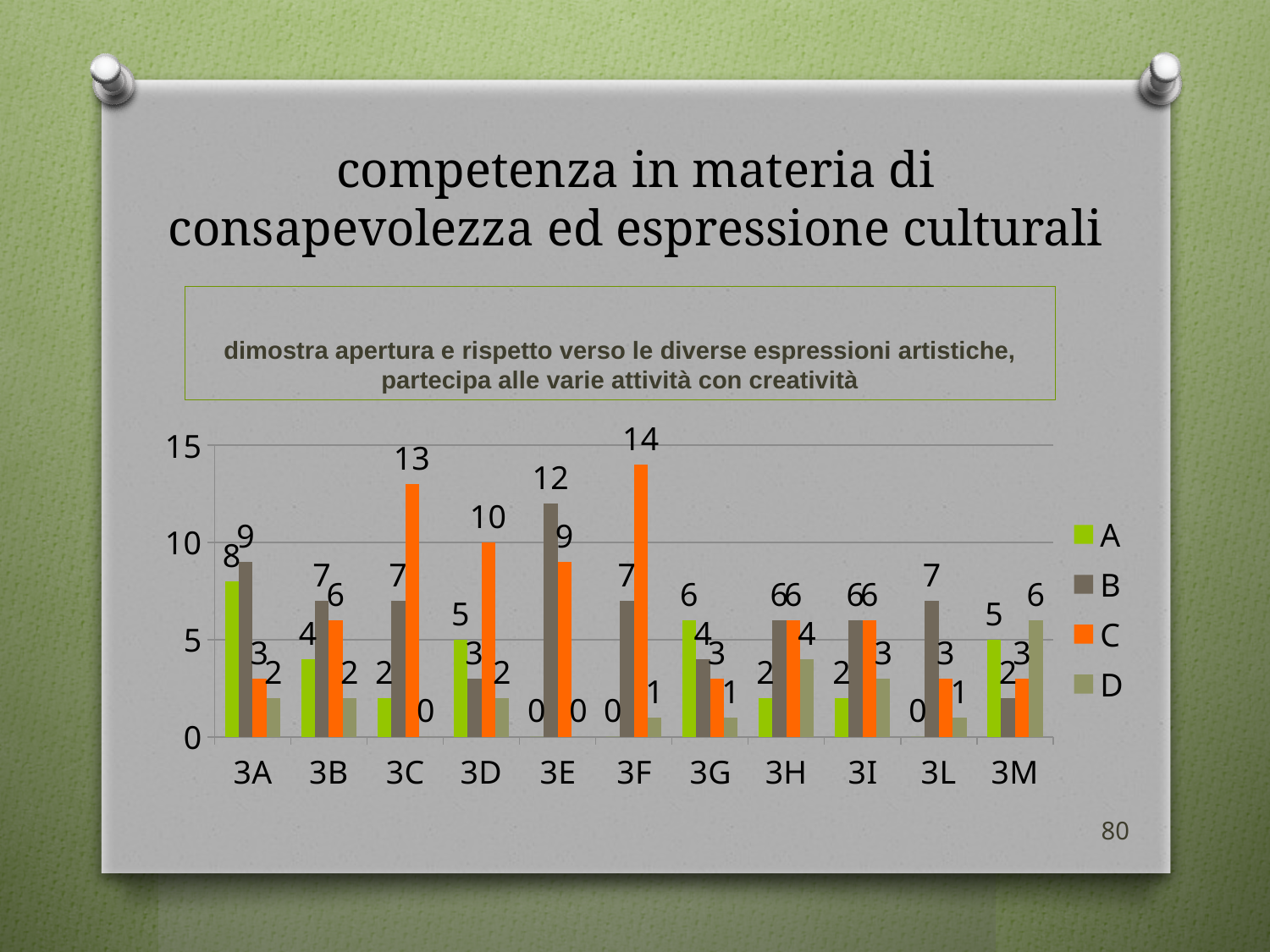
What is the value of series C for class 3C? 13 Which class has the highest value for series C? 3F Which class has the lowest value for series B? 3M How many classes are shown on the x axis? 11 What is the difference between series C and series B for class 3F? 7 For class 3A, which is larger: series A or series B? B What is the value of series D for class 3M? 6 How many series does the legend list? 4 Which class has the highest value for series A? 3A What is the value of series B for class 3E? 12 What is the value of series A for class 3G? 6 What is the difference between series C and series A for class 3C? 11